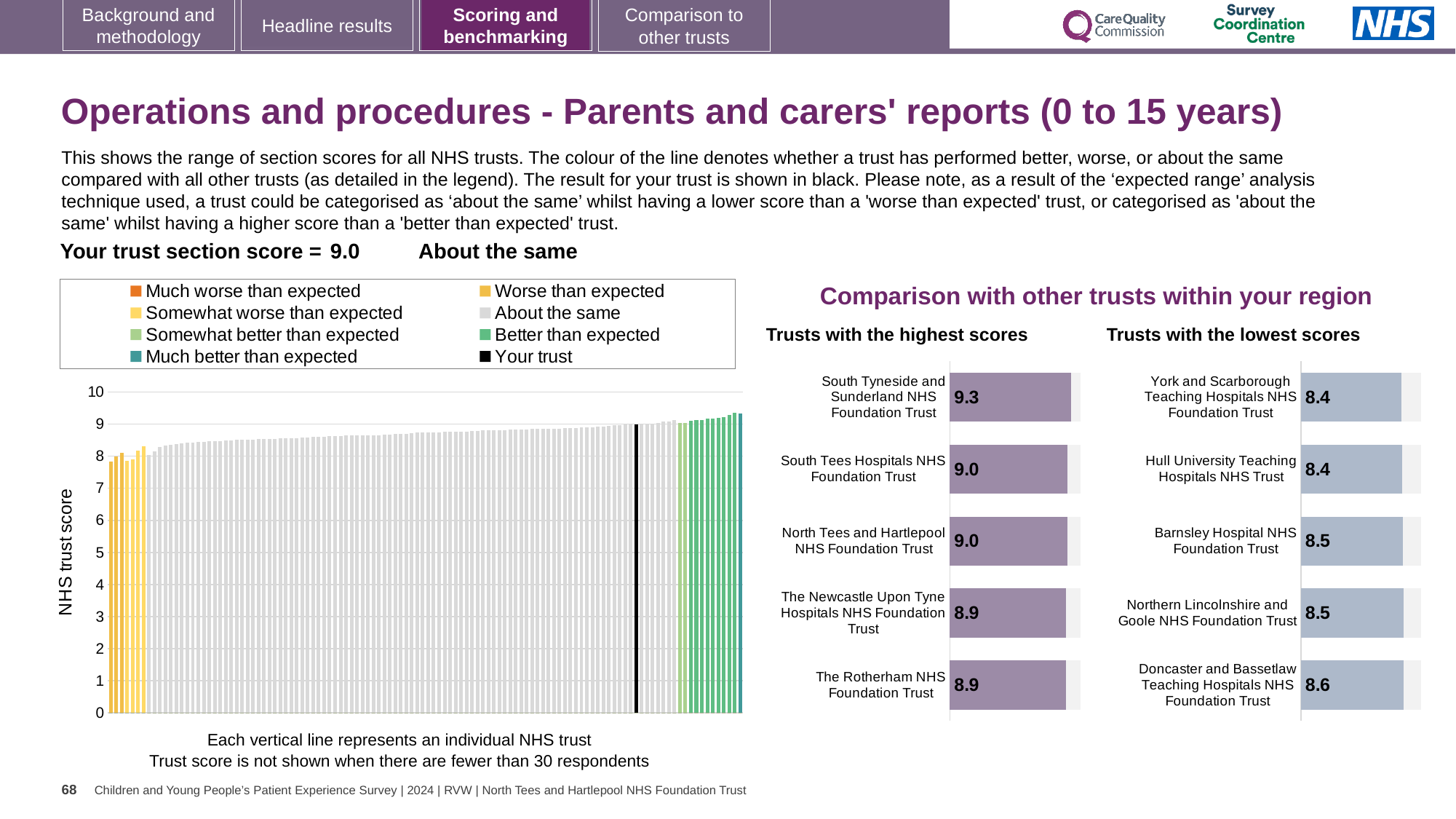
How many entries does the legend of the left-hand chart list? 8 In the left-hand chart, what is the section score for your trust (shown in black)? 9.0 In the 'Trusts with the lowest scores' chart, what is the difference between the scores of Doncaster and Bassetlaw Teaching Hospitals NHS Foundation Trust and Hull University Teaching Hospitals NHS Trust? 0.2 In the 'Trusts with the highest scores' chart, what is the score for South Tyneside and Sunderland NHS Foundation Trust? 9.3 What is the title above the two small bar charts on the right of the slide? Comparison with other trusts within your region In the 'Trusts with the highest scores' chart, which trust has the highest score? South Tyneside and Sunderland NHS Foundation Trust In the 'Trusts with the lowest scores' chart, what is the score for Doncaster and Bassetlaw Teaching Hospitals NHS Foundation Trust? 8.6 What kind of chart is the large chart on the left showing NHS trust scores? Bar chart In the 'Trusts with the highest scores' chart, what is the difference between the scores of South Tyneside and Sunderland NHS Foundation Trust and The Rotherham NHS Foundation Trust? 0.4 In the left-hand chart, is the value for your trust (the black bar) greater or less than 8? greater How many trusts are shown in the 'Trusts with the highest scores' chart? 5 In the 'Trusts with the lowest scores' chart, which has the larger score: Barnsley Hospital NHS Foundation Trust or York and Scarborough Teaching Hospitals NHS Foundation Trust? Barnsley Hospital NHS Foundation Trust